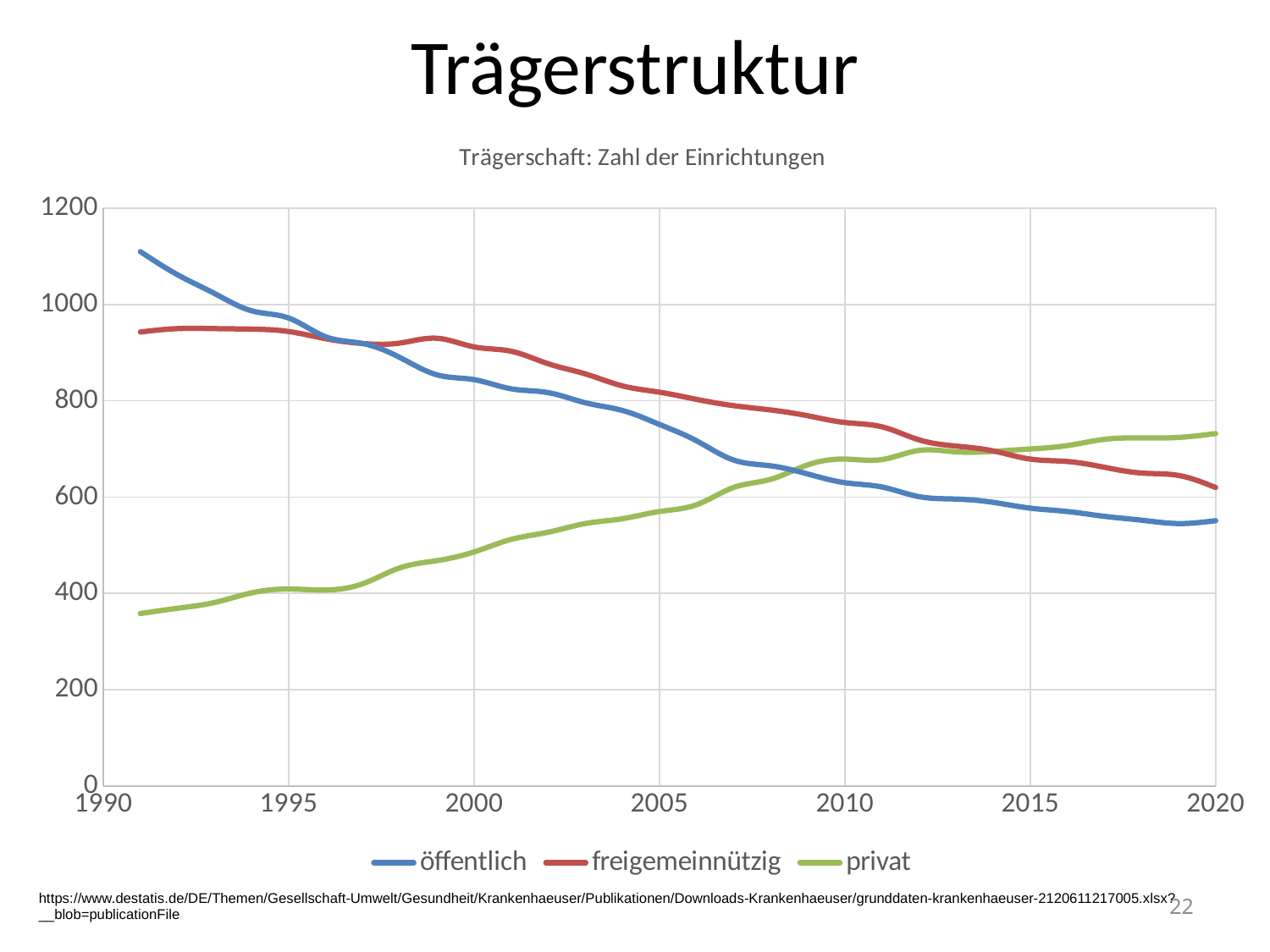
Which series has the highest value in 2020? privat Is the value for 'privat' in 1991 greater or less than 400? less Does the 'freigemeinnützig' series rise or fall from 1991 to 2020? fall Which colour is used for the 'privat' series? green Does the 'privat' series rise or fall from 1991 to 2020? rise Is the value for 'öffentlich' in 2020 greater or less than 600? less In 1991, which is larger: 'öffentlich' or 'freigemeinnützig'? öffentlich How many series does the legend list? 3 What kind of chart is shown on the slide? line chart What is the title of the chart? Trägerschaft: Zahl der Einrichtungen Is the value for 'öffentlich' in 1991 greater or less than 1000? greater Does the 'öffentlich' series rise or fall from 1991 to 2020? fall